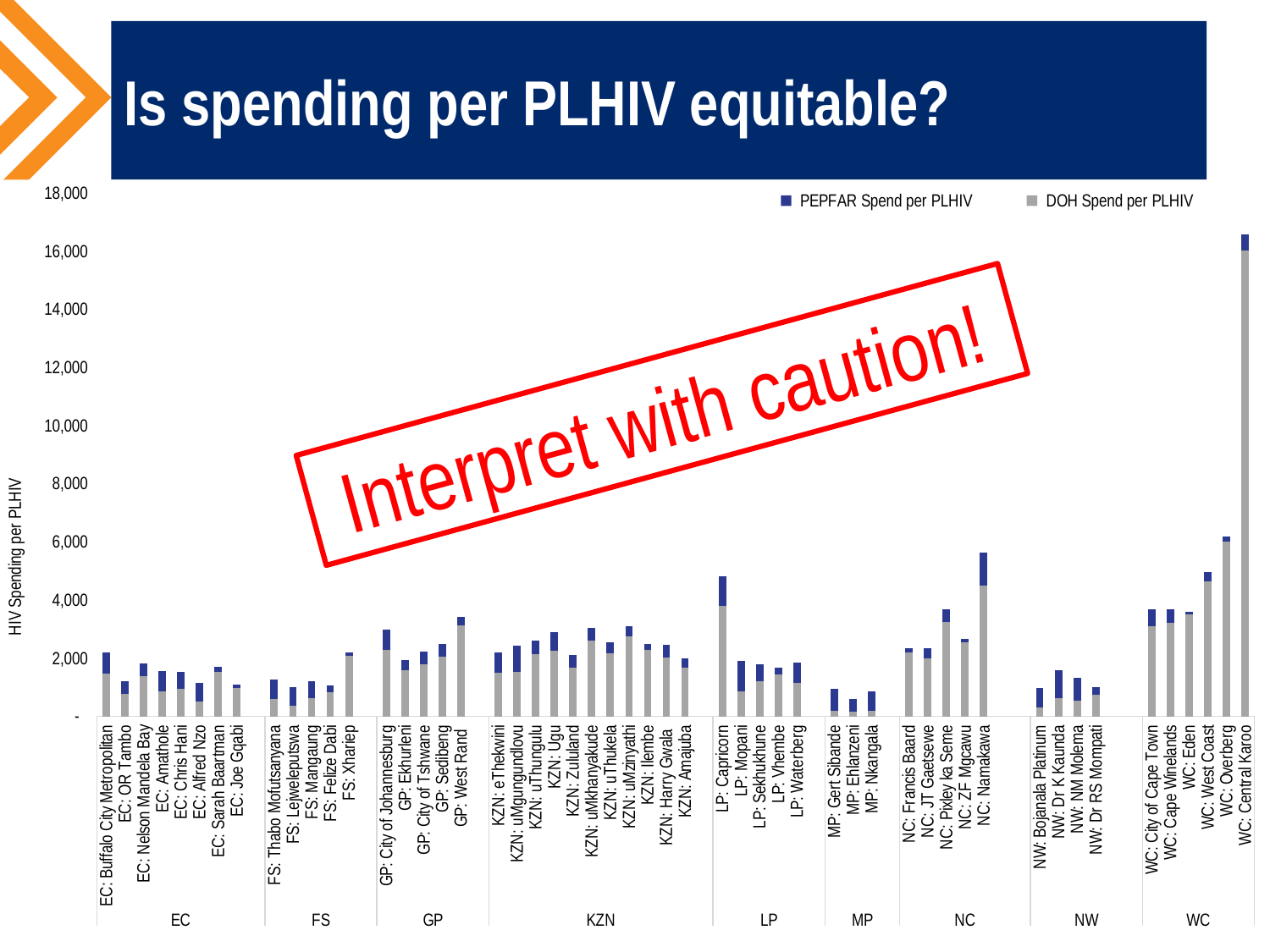
Which district has the lowest total HIV spending per PLHIV? MP: Ehlanzeni Is the total value for WC: Central Karoo greater or less than 14,000? greater Which has the larger total spending per PLHIV, LP: Capricorn or LP: Mopani? LP: Capricorn What kind of chart is shown on the slide? stacked bar chart Which district has the highest total HIV spending per PLHIV? WC: Central Karoo How many province groups are shown along the x axis? 9 Which has the larger total spending per PLHIV, WC: Central Karoo or NC: Namakawa? WC: Central Karoo Is the total value for MP: Ehlanzeni greater or less than 2,000? less Which series is shown in blue in the legend? PEPFAR Spend per PLHIV How many series does the legend list? 2 Is the total value for EC: Buffalo City Metropolitan greater or less than 4,000? less